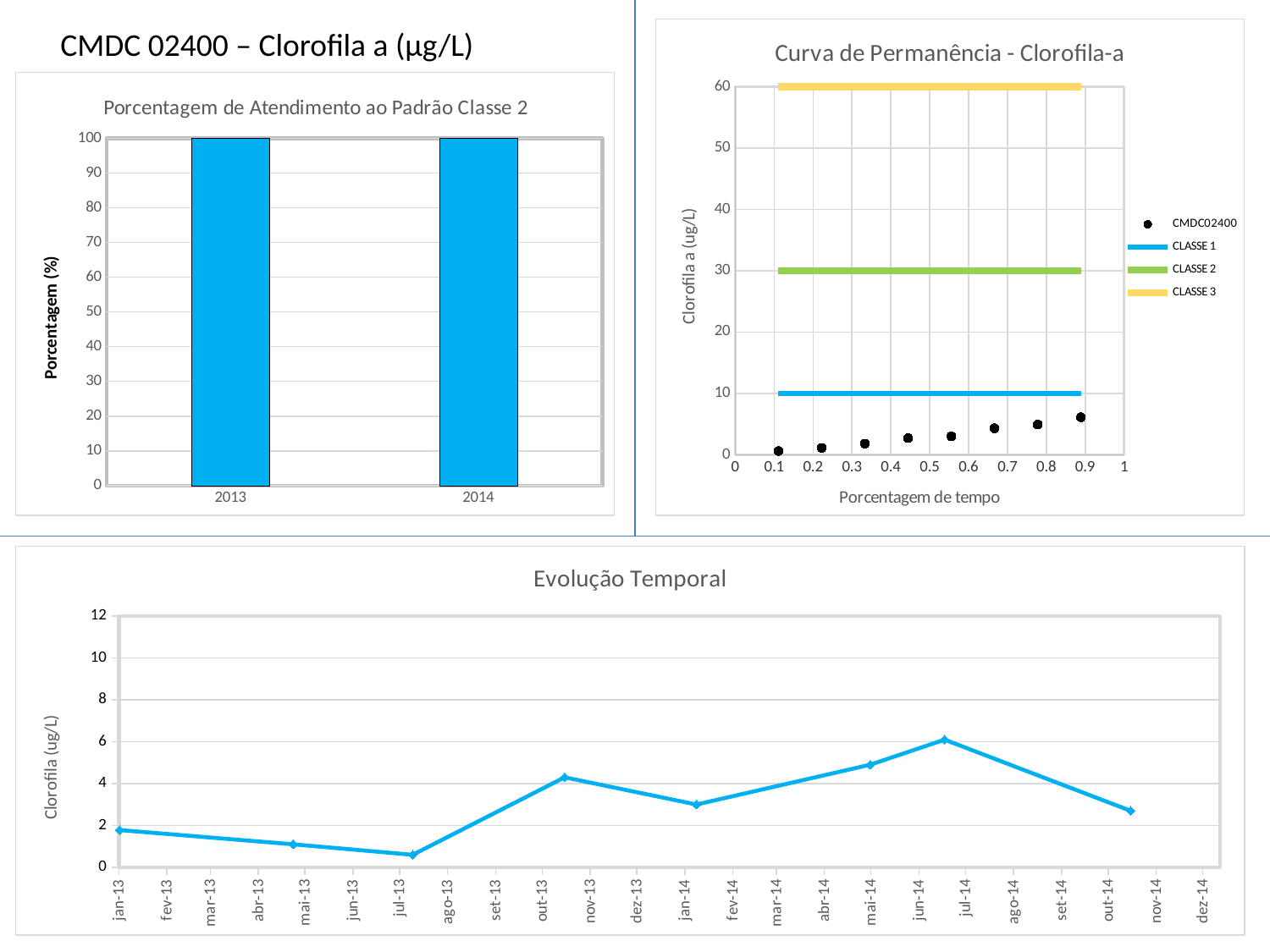
In the chart 'Curva de Permanência - Clorofila-a', at what value is the CLASSE 1 line drawn? 10 In the chart 'Curva de Permanência - Clorofila-a', is the highest CMDC02400 point greater or less than 10? less In the chart 'Curva de Permanência - Clorofila-a', at what value is the CLASSE 2 line drawn? 30 How many categories are shown on the x axis of the chart 'Porcentagem de Atendimento ao Padrão Classe 2'? 2 In the chart 'Curva de Permanência - Clorofila-a', at what value is the CLASSE 3 line drawn? 60 In the chart 'Curva de Permanência - Clorofila-a', do the CMDC02400 points rise or fall as the percentage of time increases? rise What kind of chart is 'Porcentagem de Atendimento ao Padrão Classe 2'? bar chart In the chart 'Porcentagem de Atendimento ao Padrão Classe 2', what is the value for 2013? 100 How many entries does the legend of the chart 'Curva de Permanência - Clorofila-a' list? 4 In the chart 'Porcentagem de Atendimento ao Padrão Classe 2', what is the value for 2014? 100 What kind of chart is 'Evolução Temporal'? line chart